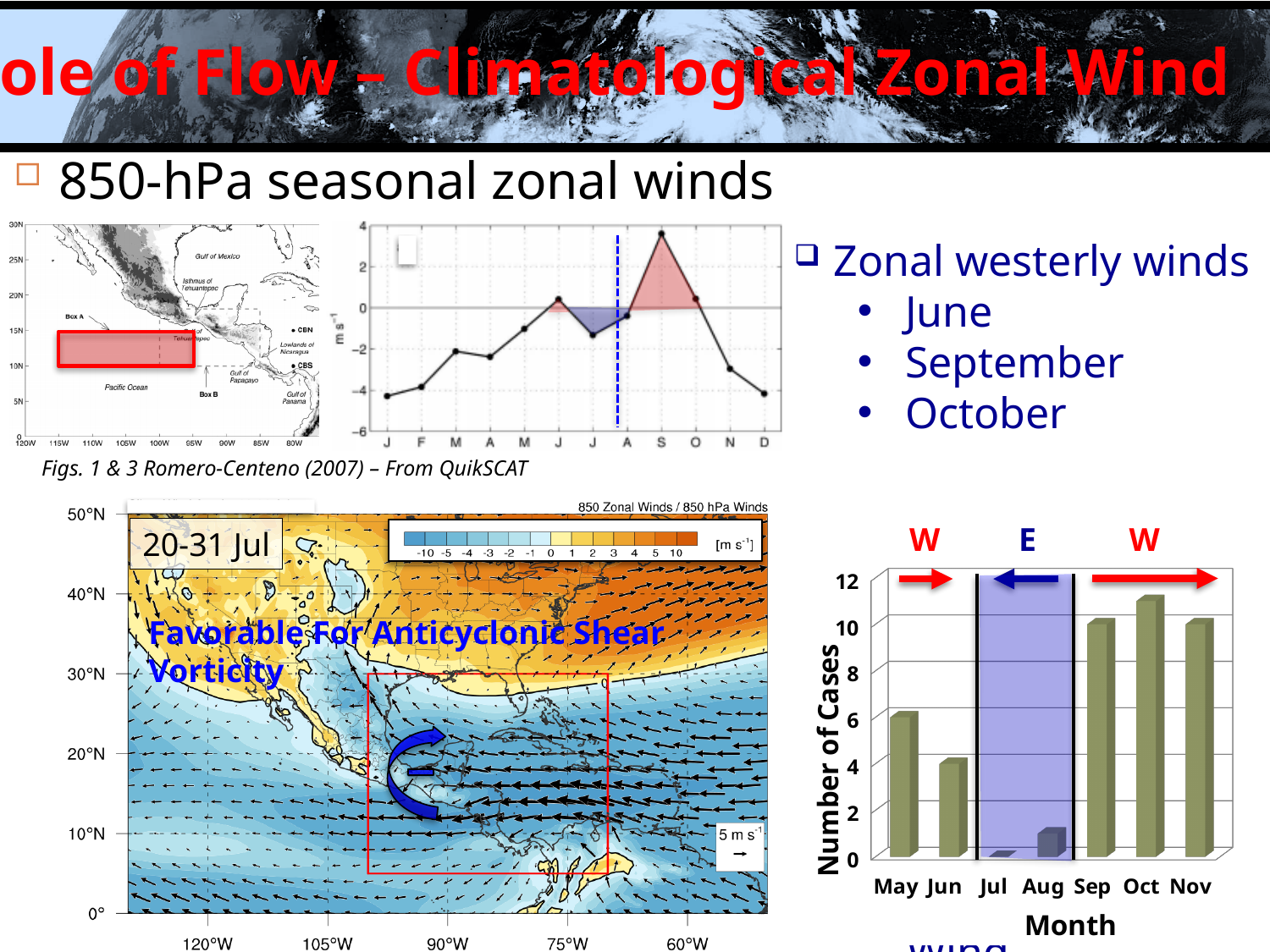
In the 'Number of Cases' bar chart, which month has the lowest number of cases? Jul In the 850-hPa seasonal zonal wind line chart at the top of the slide, which month has the highest value? S In the 'Number of Cases' bar chart, which month has the highest number of cases? Oct In the 'Number of Cases' bar chart, is the value for Sep greater or less than 8? greater In the 850-hPa seasonal zonal wind line chart at the top of the slide, is the value for J (January) greater or less than -2? less In the 'Number of Cases' bar chart, what is the title of the y axis? Number of Cases What kind of chart is the 'Number of Cases' chart at the bottom right of the slide? bar chart In the 'Number of Cases' bar chart, which month has more cases, May or Jun? May In the 'Number of Cases' bar chart, how many months are shown on the x axis? 7 In the 850-hPa seasonal zonal wind line chart at the top of the slide, is the value for S (September) greater or less than 2? greater In the 850-hPa seasonal zonal wind line chart at the top of the slide, how many monthly points are plotted? 12